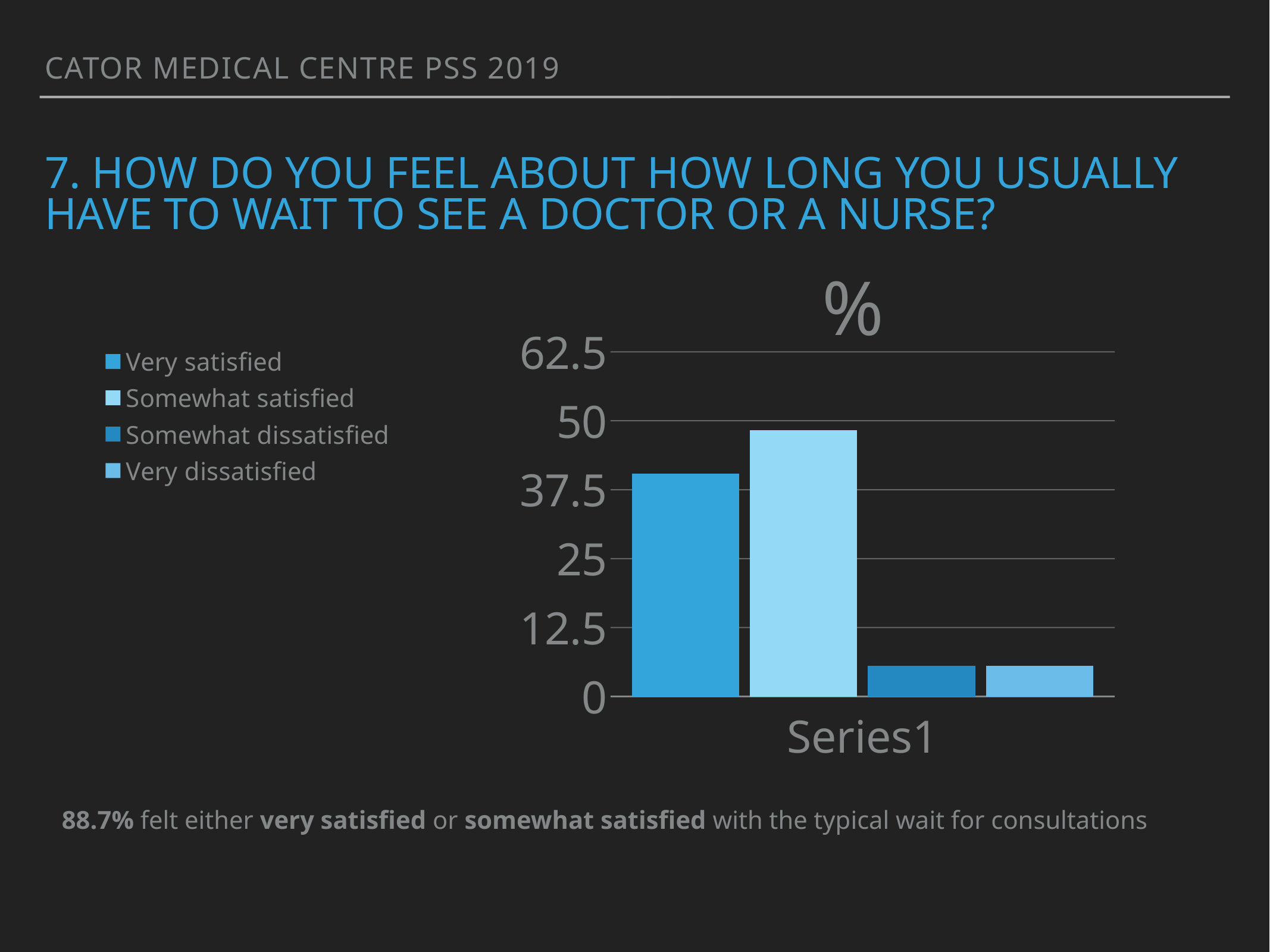
Is the value for Somewhat satisfied greater or less than 37.5? greater Which is larger, the bar for Somewhat satisfied or the bar for Somewhat dissatisfied? Somewhat satisfied Is the value for Somewhat dissatisfied greater or less than 12.5? less Is the value for Very satisfied greater or less than 25? greater What is the title of the chart? % How many series does the chart legend list? 4 Which series has the highest bar in the chart? Somewhat satisfied What kind of chart is shown on the slide? bar chart How many bars are plotted in the chart? 4 Which is larger, the bar for Very satisfied or the bar for Somewhat satisfied? Somewhat satisfied What is the label shown on the x axis of the chart? Series1